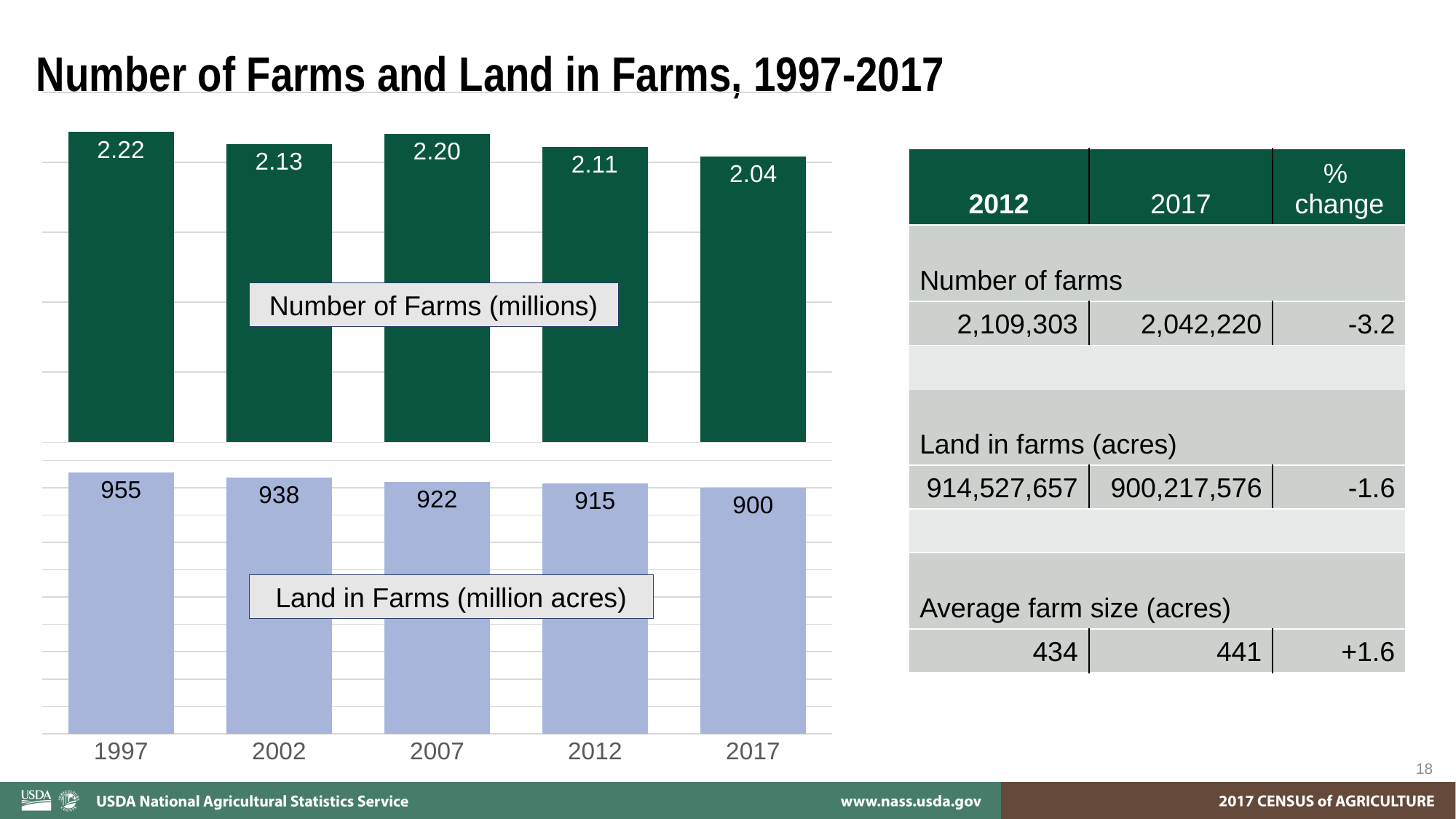
In the Number of Farms (millions) chart, what is the value for 2017? 2.04 In the Number of Farms (millions) chart, what is the value for 1997? 2.22 In the Number of Farms (millions) chart, which is larger, the value for 2002 or the value for 2007? 2007 In the Land in Farms (million acres) chart, do the values generally rise or fall from 1997 to 2017? fall In the Number of Farms (millions) chart, which year has the highest value? 1997 In the Number of Farms (millions) chart, what is the difference between the 2007 and 2012 values? 0.09 What colour are the bars in the Land in Farms (million acres) chart? light blue What kind of chart is the Number of Farms (millions) chart? bar chart In the Land in Farms (million acres) chart, what is the value for 2007? 922 In the Land in Farms (million acres) chart, what is the difference between the 1997 and 2017 values? 55 In the Land in Farms (million acres) chart, which year has the lowest value? 2017 How many years are shown on the x axis of the Land in Farms (million acres) chart? 5